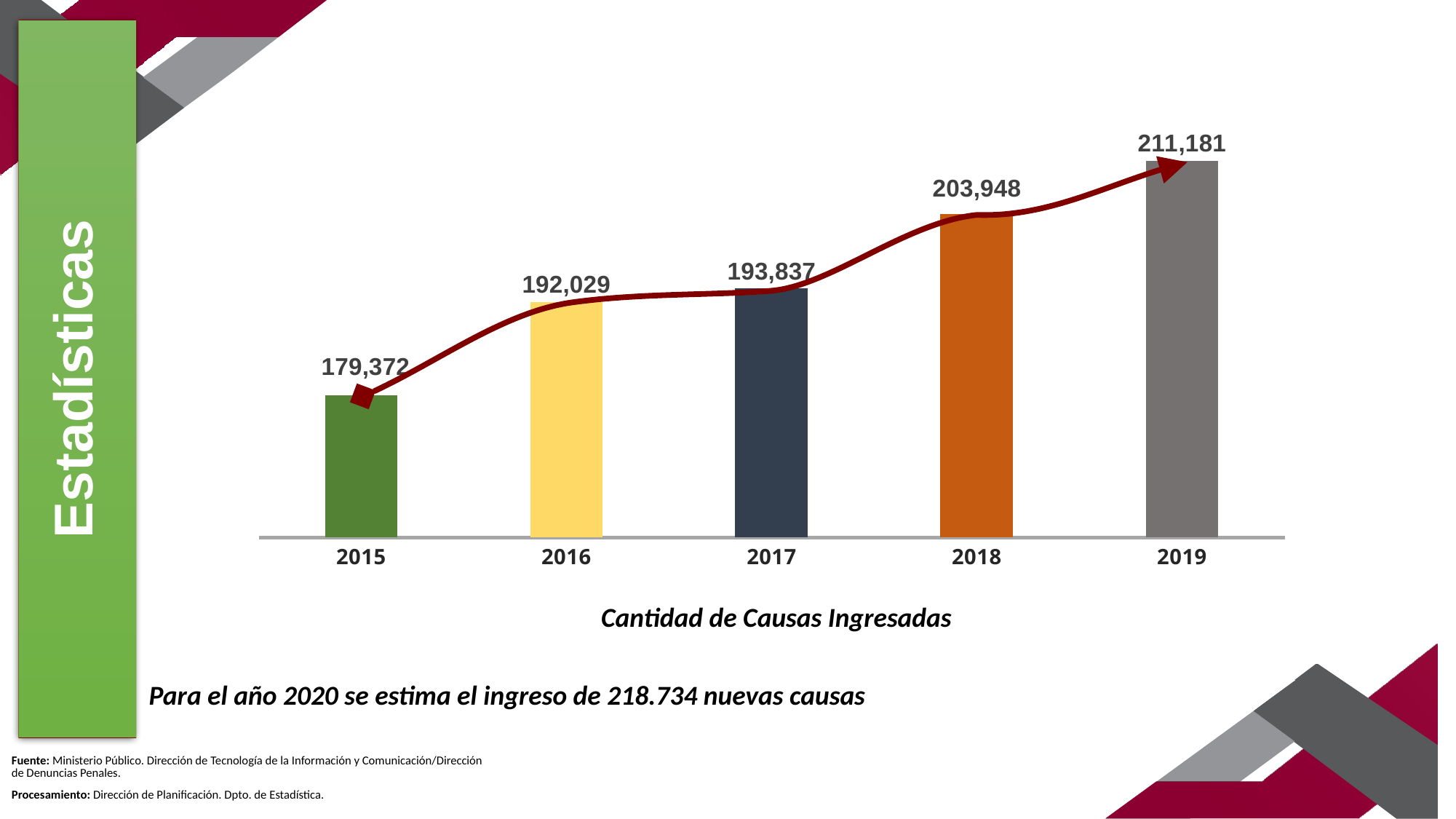
What kind of chart is this? bar chart Do the values rise or fall from 2015 to 2019? rise What is the difference between the values for 2019 and 2018? 7,233 What is the difference between the values for 2016 and 2015? 12,657 How many years are shown on the x axis? 5 Which year has the lowest value? 2015 Which is larger, the value for 2018 or the value for 2017? 2018 What is the value for 2017? 193,837 What is the value for 2019? 211,181 What is the value for 2015? 179,372 What is the title shown below the chart? Cantidad de Causas Ingresadas Which year has the highest value? 2019